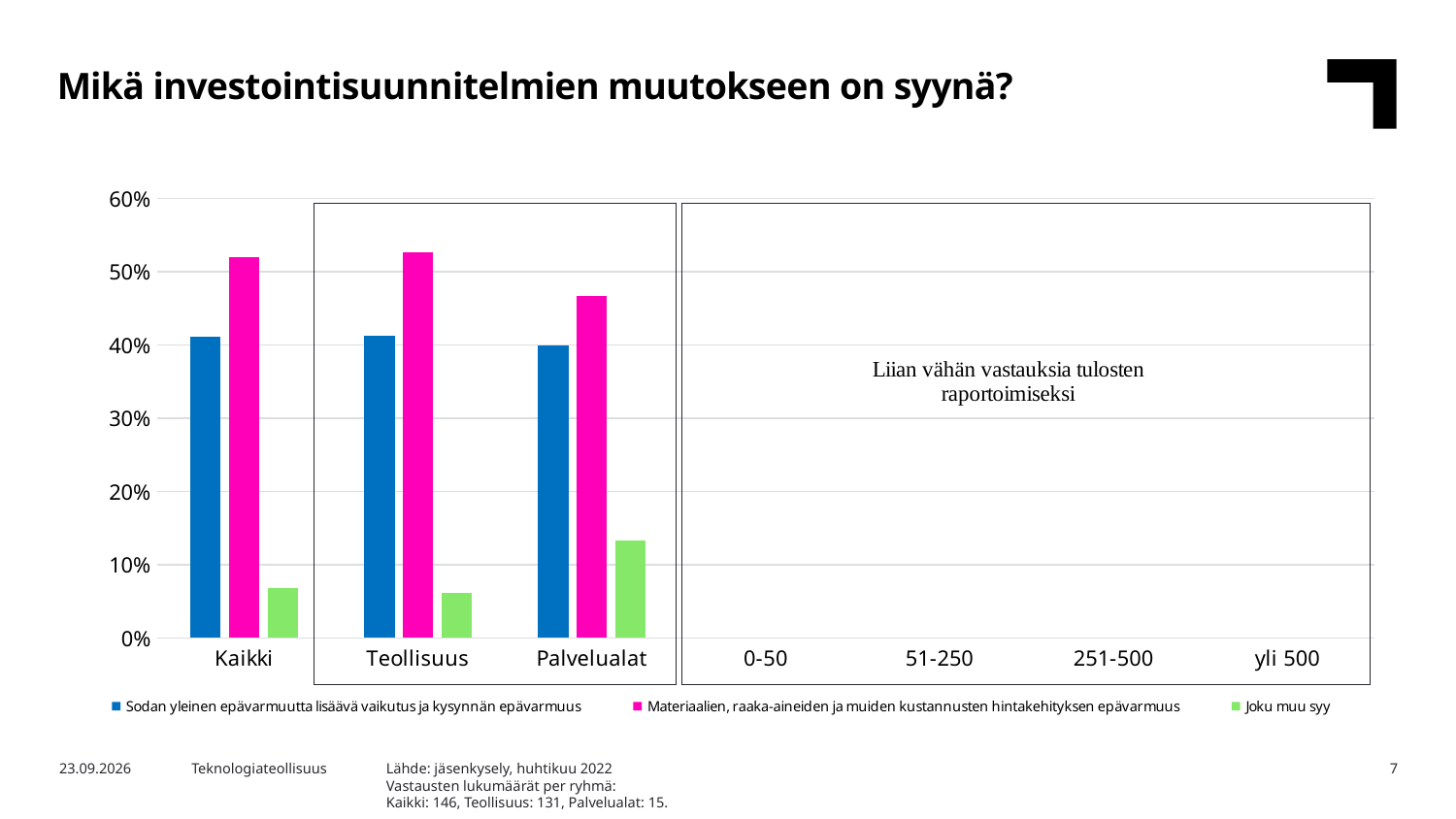
How many series does the legend list? 3 How many categories on the x axis have bars plotted? 3 Is the value for 'Materiaalien, raaka-aineiden ja muiden kustannusten hintakehityksen epävarmuus' in the Palvelualat group greater or less than 50%? less Which series has the lowest value in the Palvelualat group? Joku muu syy What text is shown in the right-hand panel of the chart instead of bars for the groups 0-50, 51-250, 251-500 and yli 500? Liian vähän vastauksia tulosten raportoimiseksi Is the value for 'Joku muu syy' in the Kaikki group greater or less than 10%? less Is the value for 'Materiaalien, raaka-aineiden ja muiden kustannusten hintakehityksen epävarmuus' larger in the Teollisuus group or the Palvelualat group? Teollisuus Is the value for 'Materiaalien, raaka-aineiden ja muiden kustannusten hintakehityksen epävarmuus' in the Kaikki group greater or less than 50%? greater Which series has the highest value in the Kaikki group? Materiaalien, raaka-aineiden ja muiden kustannusten hintakehityksen epävarmuus What kind of chart is shown on the slide? bar chart Which group has the highest value for 'Joku muu syy'? Palvelualat